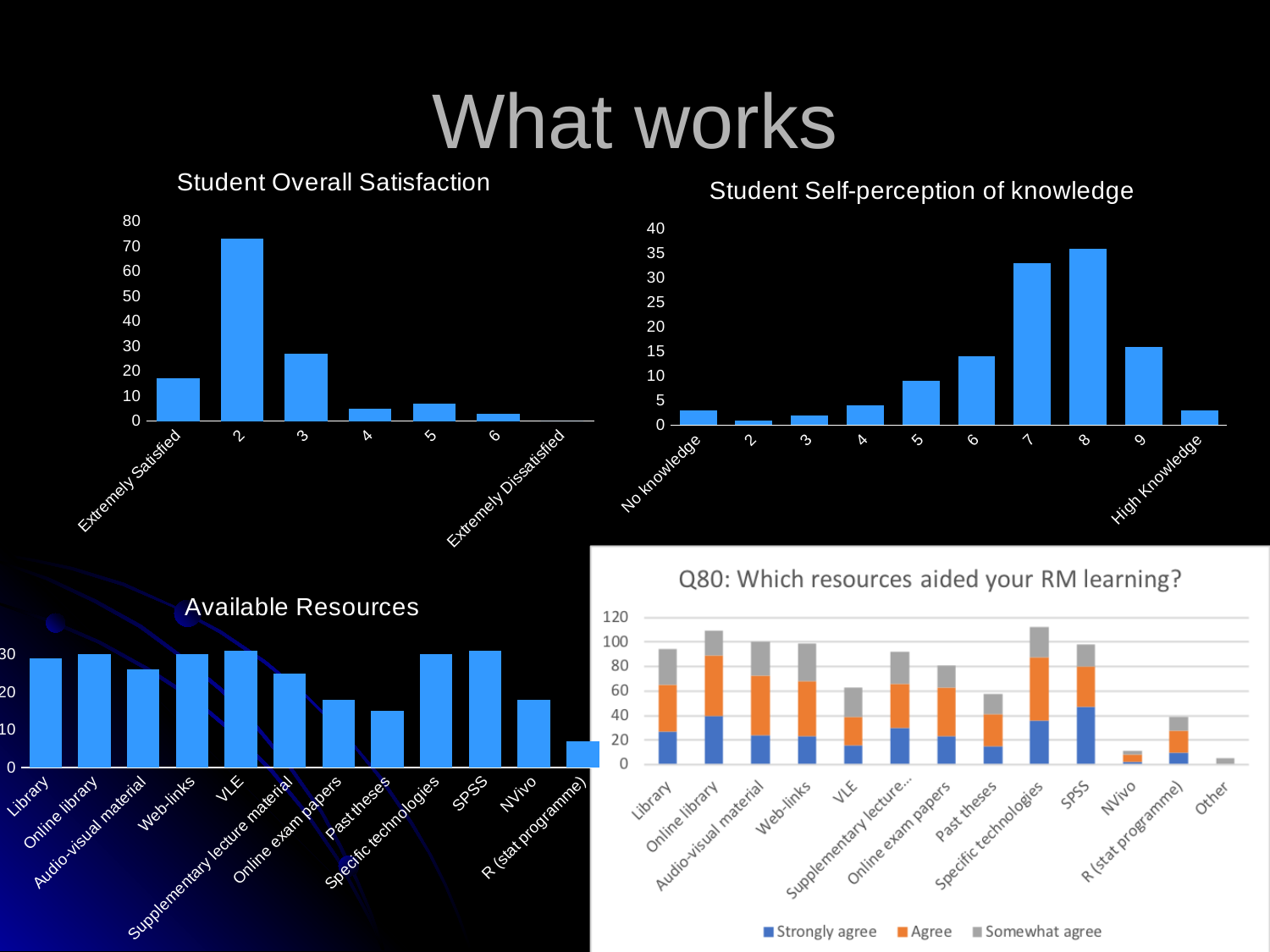
In the Student Self-perception of knowledge chart, is the value for category 7 greater or less than 30? greater How many categories are shown on the x axis of the Student Overall Satisfaction chart? 7 In the Available Resources chart, is the value for Past theses greater or less than 20? less In the Student Self-perception of knowledge chart, which category has the highest value? 8 How many series does the legend list in the chart titled Q80: Which resources aided your RM learning? 3 In the Student Overall Satisfaction chart, is the value for category 2 greater or less than 60? greater In the Available Resources chart, which category has the lowest value? R (stat programme) In the Student Self-perception of knowledge chart, which is larger, the value for 6 or the value for 9? 9 In the chart titled Q80: Which resources aided your RM learning?, which category has the lowest total? Other In the Student Self-perception of knowledge chart, which category has the lowest value? 2 In the Student Overall Satisfaction chart, which category has the highest value? 2